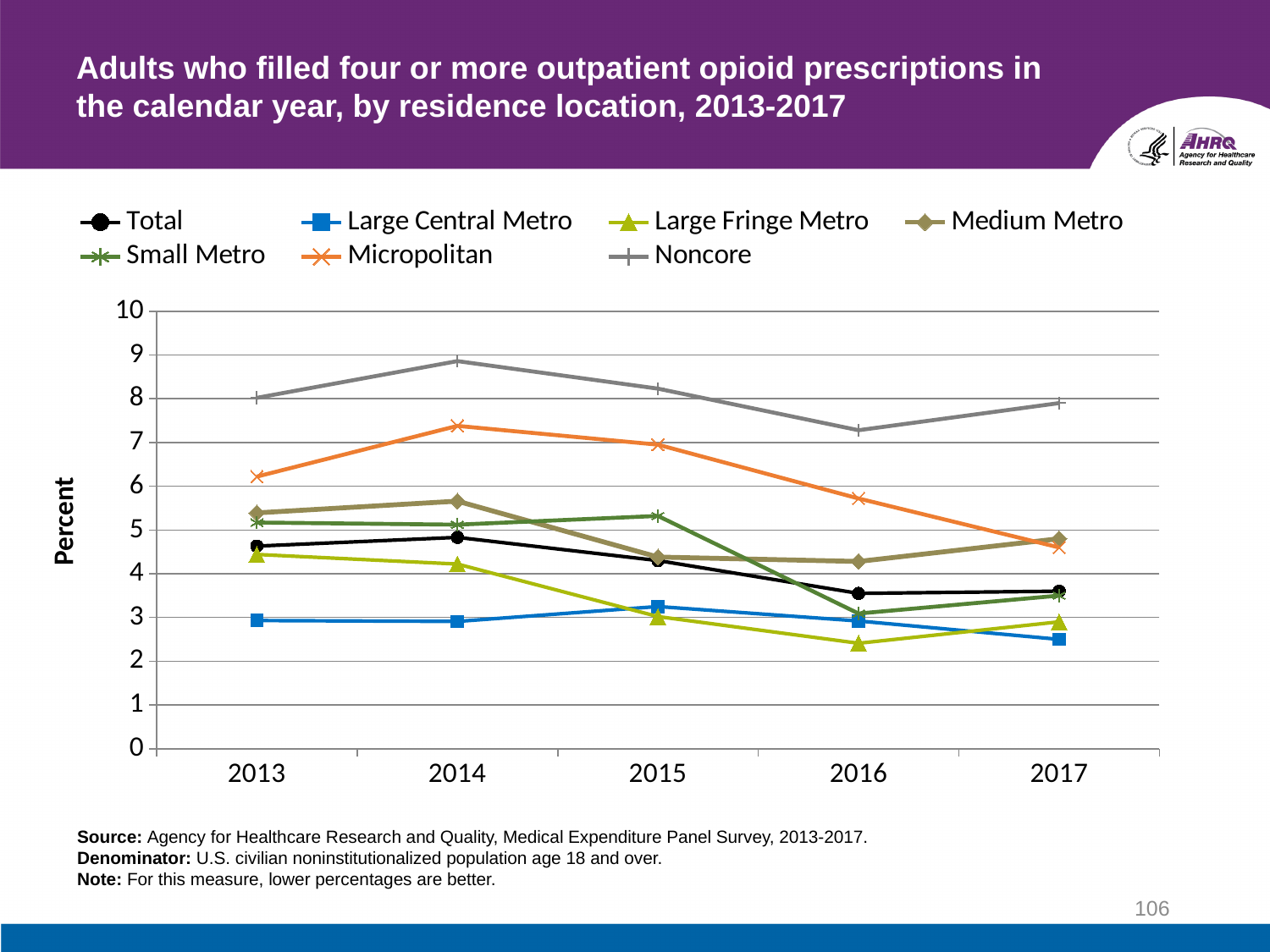
Is the value for Large Central Metro in 2013 greater or less than 4? less Which is larger in 2015, the value for Noncore or the value for Total? Noncore Which residence location has the highest value in 2014? Noncore Which residence location has the lowest value in 2013? Large Central Metro How many years are shown on the x axis? 5 What kind of chart is shown on the slide? line chart Is the value for Micropolitan in 2016 greater or less than 5? greater How many series does the legend list? 7 Is the value for Total in 2017 greater or less than 4? less Which residence location has the lowest value in 2017? Large Central Metro Does the Micropolitan line rise or fall from 2014 to 2017? fall